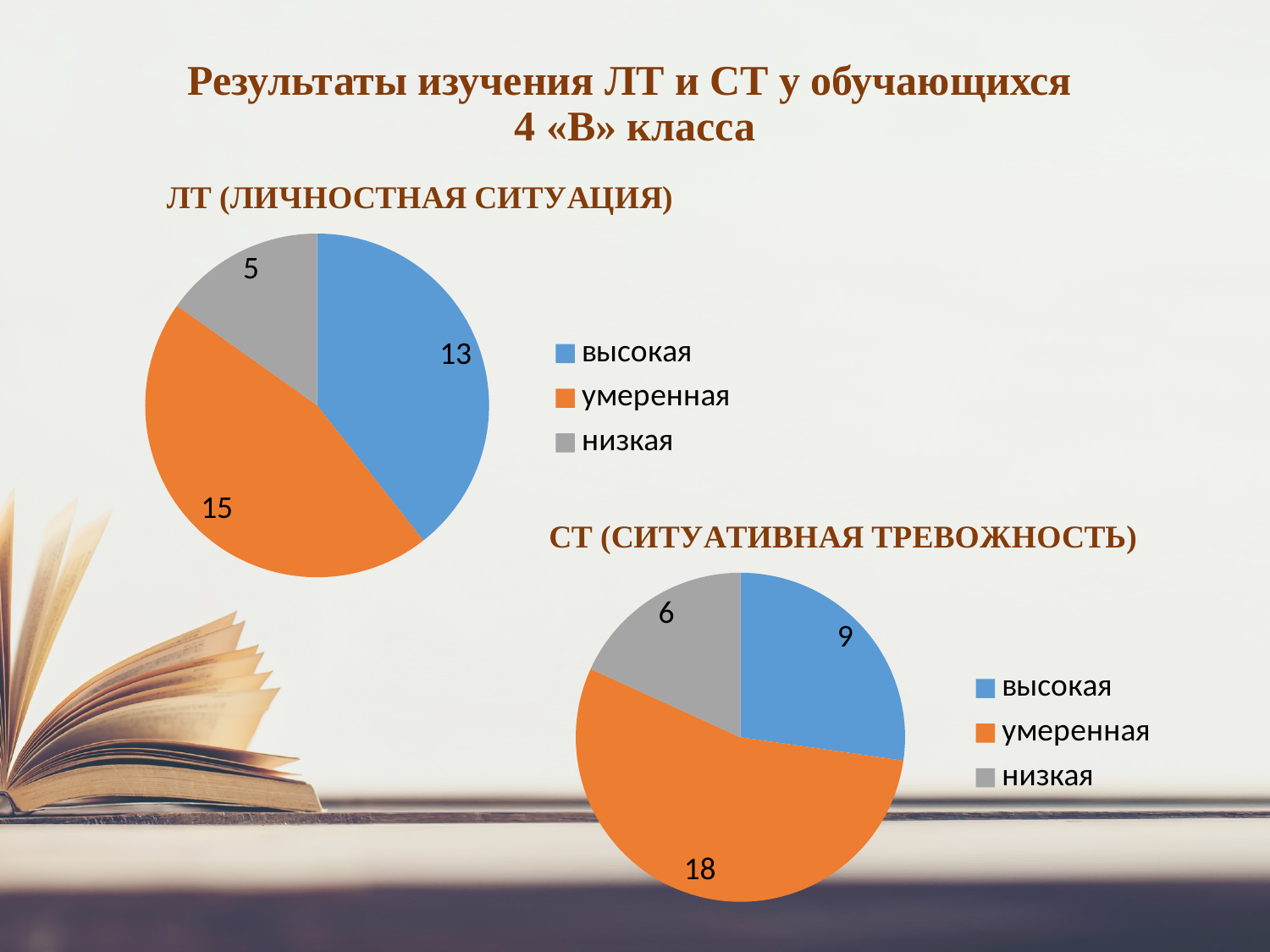
In the СТ (СИТУАТИВНАЯ ТРЕВОЖНОСТЬ) chart, what is the value for умеренная? 18 In the ЛТ (ЛИЧНОСТНАЯ СИТУАЦИЯ) chart, which category has the largest slice? умеренная In the СТ (СИТУАТИВНАЯ ТРЕВОЖНОСТЬ) chart, which category has the smallest slice? низкая In the СТ (СИТУАТИВНАЯ ТРЕВОЖНОСТЬ) chart, what is the difference between умеренная and высокая? 9 In the ЛТ (ЛИЧНОСТНАЯ СИТУАЦИЯ) chart, what is the value for умеренная? 15 In the СТ (СИТУАТИВНАЯ ТРЕВОЖНОСТЬ) chart, what is the value for высокая? 9 In the ЛТ (ЛИЧНОСТНАЯ СИТУАЦИЯ) chart, what is the value for низкая? 5 In the СТ (СИТУАТИВНАЯ ТРЕВОЖНОСТЬ) chart, what colour is the умеренная slice? orange In the ЛТ (ЛИЧНОСТНАЯ СИТУАЦИЯ) chart, what is the difference between умеренная and низкая? 10 Which is larger in the ЛТ (ЛИЧНОСТНАЯ СИТУАЦИЯ) chart: высокая or низкая? высокая What type of chart is the ЛТ (ЛИЧНОСТНАЯ СИТУАЦИЯ) chart? pie chart How many categories does the СТ (СИТУАТИВНАЯ ТРЕВОЖНОСТЬ) chart show? 3